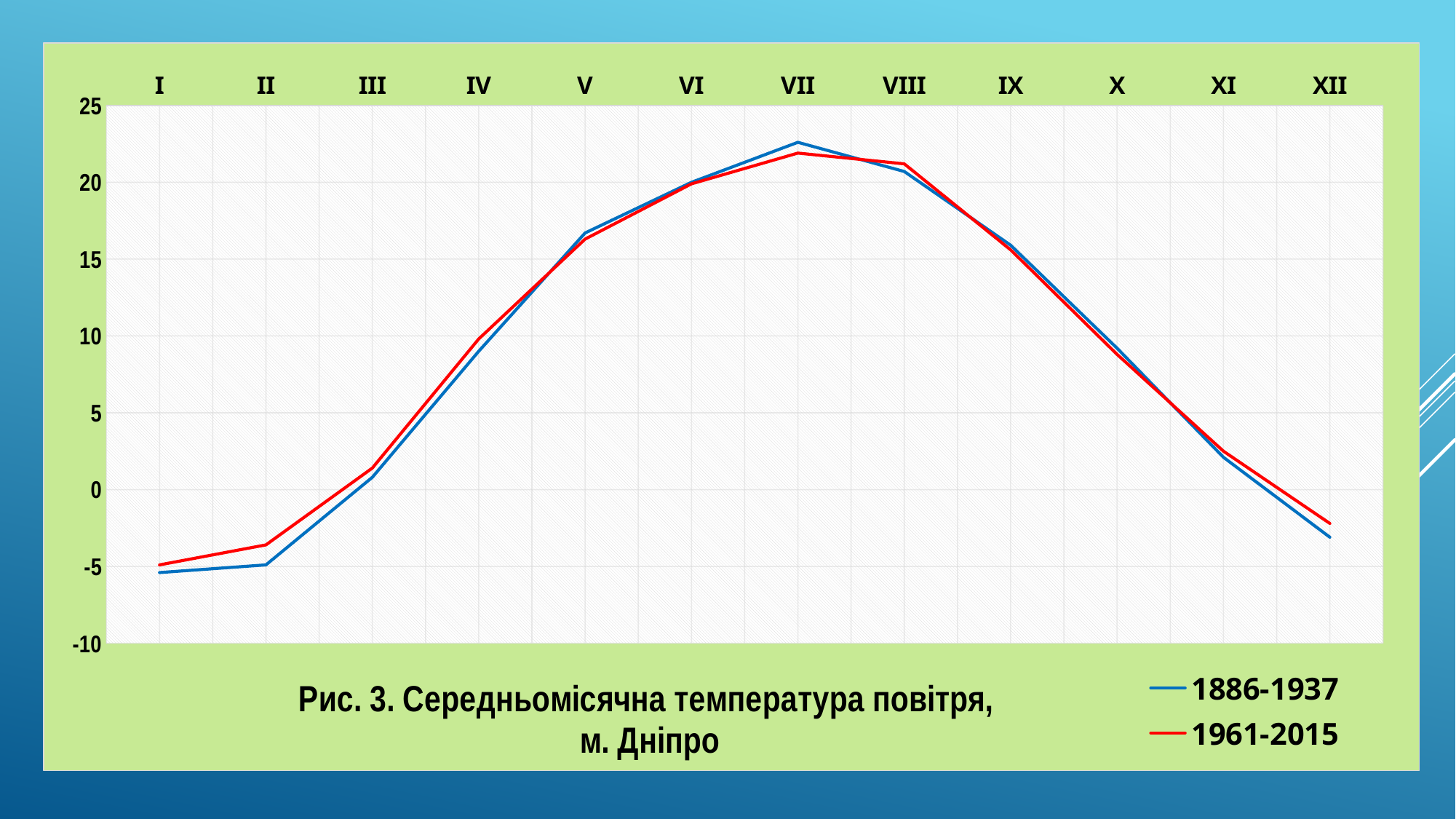
In which month does the 1886-1937 series reach its lowest value? I In which month does the 1886-1937 series reach its highest value? VII Is the value for the 1961-2015 series in month I greater or less than 0? less Do the values of the 1961-2015 series rise or fall from month I to month VII? rise In month II, which series has the higher value, 1886-1937 or 1961-2015? 1961-2015 What kind of chart is shown on the slide? line chart How many months (categories) are plotted along the x axis? 12 Is the value for the 1961-2015 series in month VI greater or less than 15? greater How many series does the legend list? 2 In month VII, which series has the higher value, 1886-1937 or 1961-2015? 1886-1937 Is the value for the 1886-1937 series in month VII greater or less than 20? greater In which month does the 1961-2015 series reach its lowest value? I